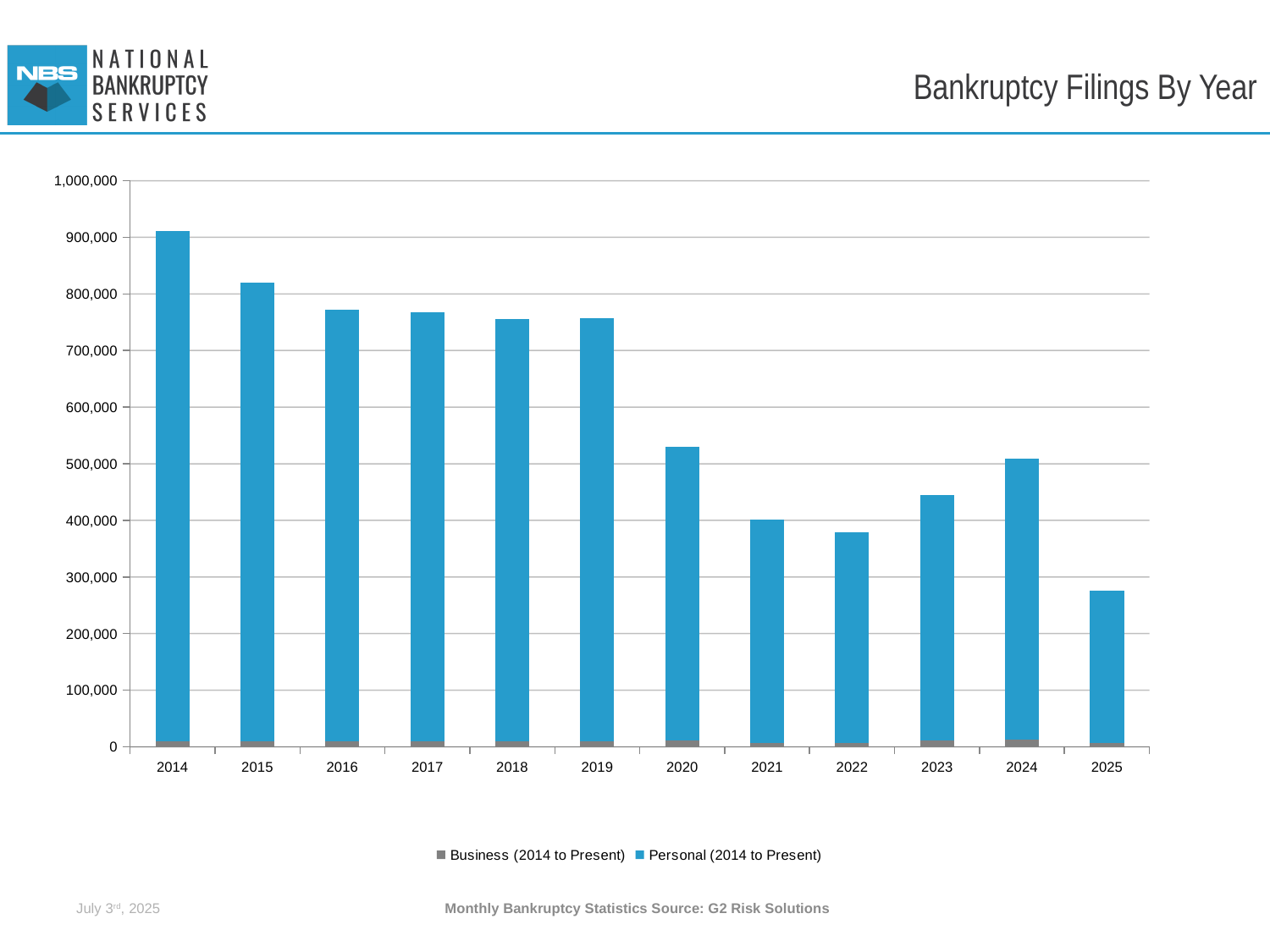
How many years are shown on the x axis of the chart? 12 What kind of chart is shown on the slide? bar chart What is the title of the chart? Bankruptcy Filings By Year Which year has the larger total filings, 2020 or 2021? 2020 Is the total value for 2014 greater or less than 800,000? greater Is the total value for 2023 greater or less than 500,000? less Is the total value for 2025 greater or less than 300,000? less Which year has the highest total bankruptcy filings? 2014 Which year has the lowest total bankruptcy filings? 2025 Do total bankruptcy filings rise or fall from 2014 to 2019? fall How many series does the chart's legend list? 2